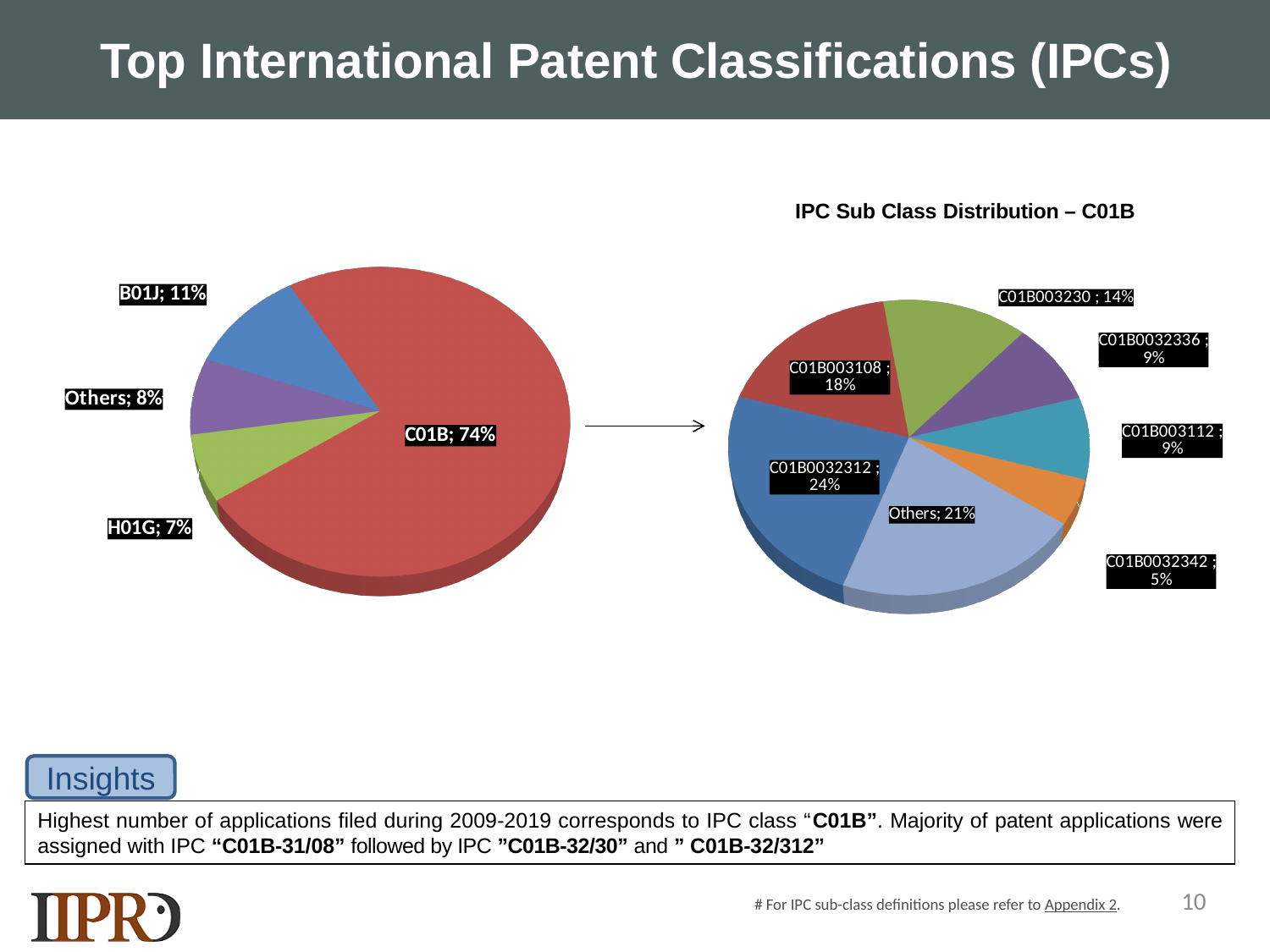
In the chart titled 'IPC Sub Class Distribution – C01B', which sub class has the smallest share? C01B0032342 In the left pie chart, what is the difference in percentage points between C01B and B01J? 63 What type of chart is used on the right side of the slide? Pie chart In the left pie chart, what is the share for B01J? 11% In the chart titled 'IPC Sub Class Distribution – C01B', what is the share for C01B003108? 18% In the left pie chart, what is the share for H01G? 7% In the left pie chart, which category has the smallest share? H01G In the left pie chart, what share does C01B hold? 74% In the chart titled 'IPC Sub Class Distribution – C01B', which is larger: C01B003230 or C01B0032336? C01B003230 In the left pie chart, how many slices are there? 4 In the chart titled 'IPC Sub Class Distribution – C01B', what is the share for C01B0032312? 24% In the chart titled 'IPC Sub Class Distribution – C01B', how many slices are there? 7